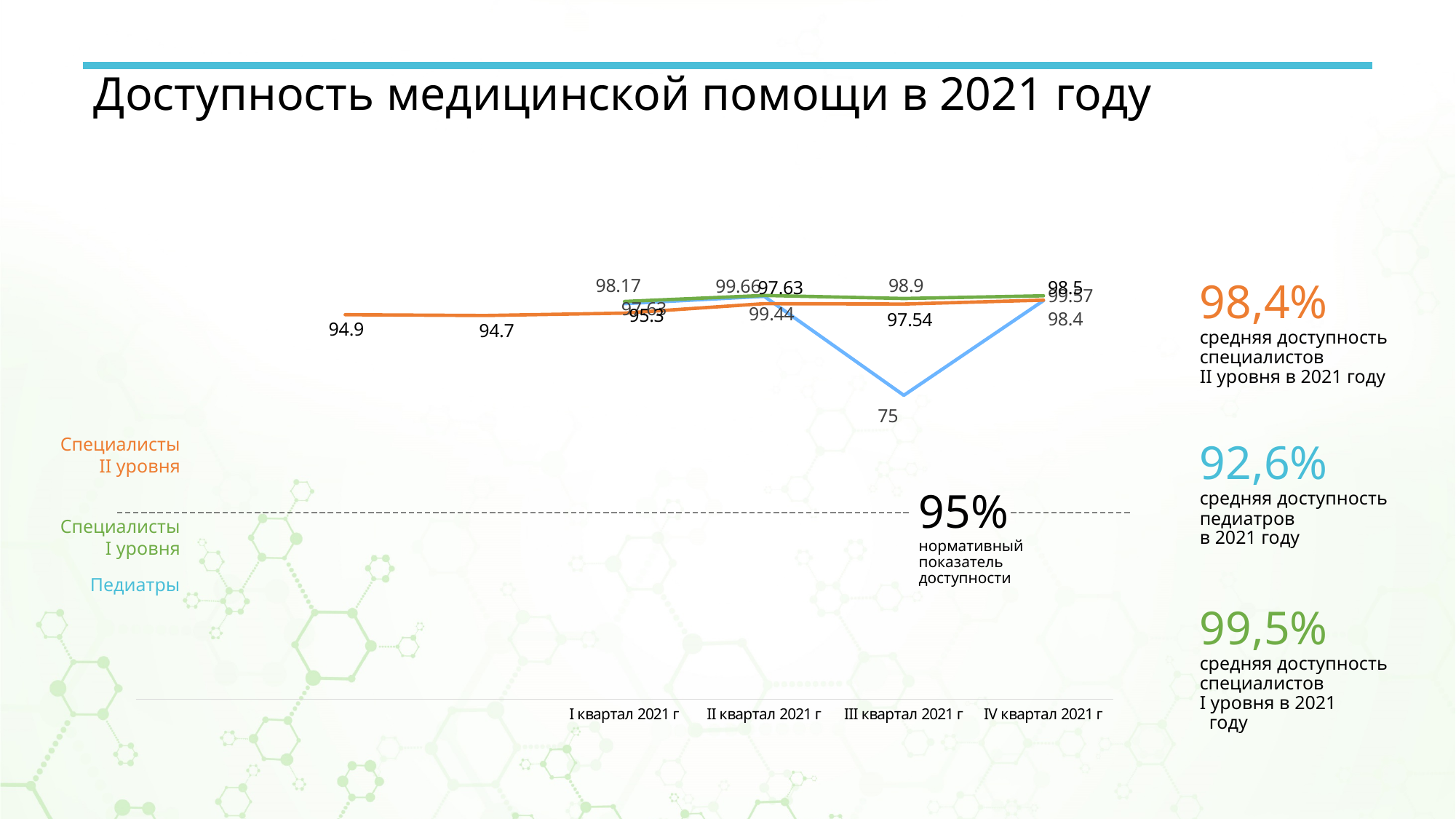
Which is larger in III квартал 2021 г: the value for Педиатры or the value for Специалисты I уровня? Специалисты I уровня In which quarter is the value for Педиатры lowest? III квартал 2021 г What normative accessibility indicator (нормативный показатель доступности) is marked by the dashed line on the chart? 95% What is the value for Педиатры in IV квартал 2021 г? 98.4 What is the value for Специалисты I уровня in II квартал 2021 г? 99.66 What is the value for Педиатры in III квартал 2021 г? 75 What is the value for Специалисты I уровня in III квартал 2021 г? 98.9 What is the difference between the Педиатры values in IV квартал 2021 г and III квартал 2021 г? 23.4 Is the value for Педиатры in III квартал 2021 г greater or less than 95? less How many quarters are labelled on the x axis of the chart? 4 How many series does the chart's legend list? 3 What kind of chart is shown on the slide? line chart